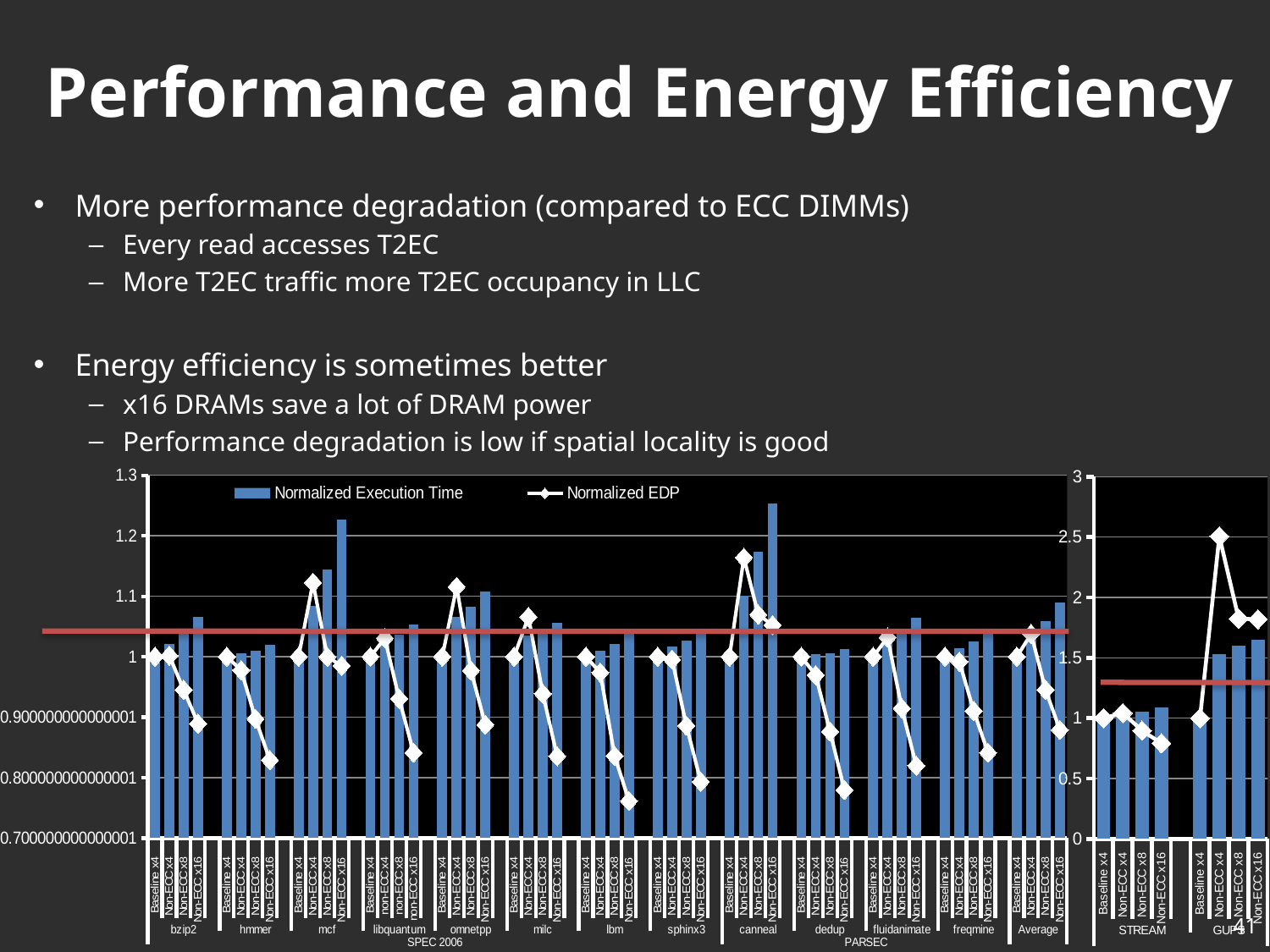
In the right chart, is the Normalized EDP for Non-ECC x4 higher for GUPS or for STREAM? GUPS In the right chart, is the Normalized EDP point for Non-ECC x4 in GUPS greater or less than 2? greater What is the highest tick value on the y axis of the left chart? 1.3 What are the two series named in the legend of the left chart? Normalized Execution Time and Normalized EDP In the left chart, do the Normalized Execution Time bars for mcf rise or fall from Baseline x4 to Non-ECC x16? rise In the left chart, is the Normalized Execution Time bar for Non-ECC x16 in hmmer greater or less than 1.1? less What kind of chart is the large chart on the left of the slide? A bar chart combined with a line chart In the right chart, how many benchmark groups are shown along the x axis? 2 In the left chart, which configuration within canneal has the highest Normalized Execution Time bar? Non-ECC x16 In the left chart, how many benchmark groups (including Average) are shown along the x axis? 13 In the left chart, is the Normalized Execution Time bar for Non-ECC x16 in mcf greater or less than 1.2? greater How many series does the legend of the left chart list? 2